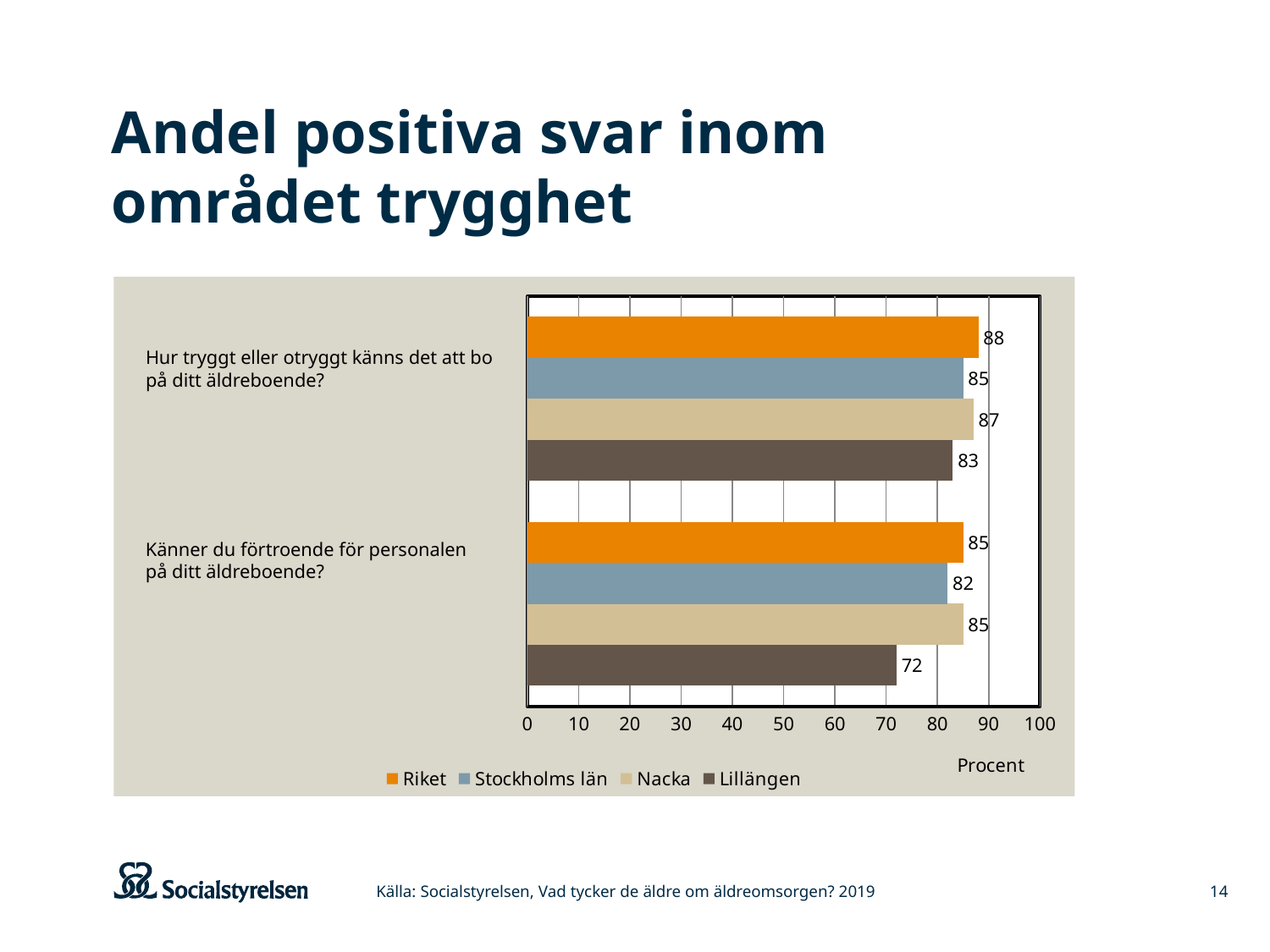
Which series has the lowest value on the question "Känner du förtroende för personalen på ditt äldreboende?"? Lillängen What is the value for Nacka on the question "Hur tryggt eller otryggt känns det att bo på ditt äldreboende?"? 87 What kind of chart is shown on the slide? Bar chart Which series has the highest value on the question "Hur tryggt eller otryggt känns det att bo på ditt äldreboende?"? Riket What is the difference between the Nacka and Stockholms län values on the question "Hur tryggt eller otryggt känns det att bo på ditt äldreboende?"? 2 What is the value for Lillängen on the question "Känner du förtroende för personalen på ditt äldreboende?"? 72 How many series does the legend list? 4 Which is larger: the Lillängen value for "Hur tryggt eller otryggt känns det att bo på ditt äldreboende?" or the Lillängen value for "Känner du förtroende för personalen på ditt äldreboende?"? Hur tryggt eller otryggt känns det att bo på ditt äldreboende? What is the label of the horizontal axis? Procent What is the difference between the Riket and Lillängen values on the question "Känner du förtroende för personalen på ditt äldreboende?"? 13 What is the value for Riket on the question "Hur tryggt eller otryggt känns det att bo på ditt äldreboende?"? 88 What is the value for Stockholms län on the question "Känner du förtroende för personalen på ditt äldreboende?"? 82